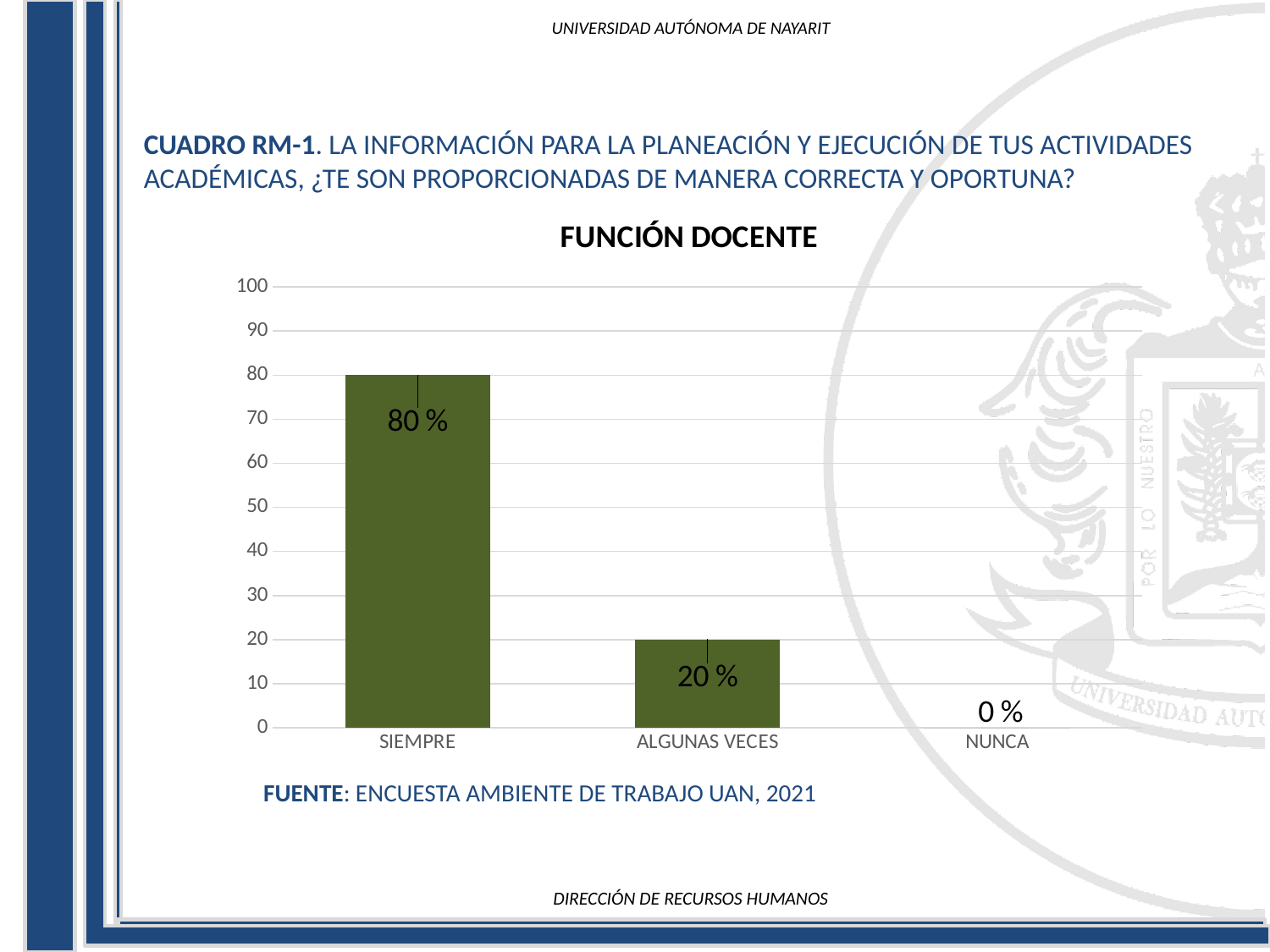
Which category has the lowest value? NUNCA What kind of chart is shown? bar chart What is the value for SIEMPRE? 80 % Which category has the highest value? SIEMPRE Do the values rise or fall from left to right along the x axis? fall What is the difference between the values for SIEMPRE and ALGUNAS VECES? 60 % Is the value for SIEMPRE greater or less than 50? greater How many categories are shown on the x axis? 3 What is the value for ALGUNAS VECES? 20 % Which is larger, the value for ALGUNAS VECES or the value for NUNCA? ALGUNAS VECES What is the value for NUNCA? 0 % What is the title of the chart? FUNCIÓN DOCENTE